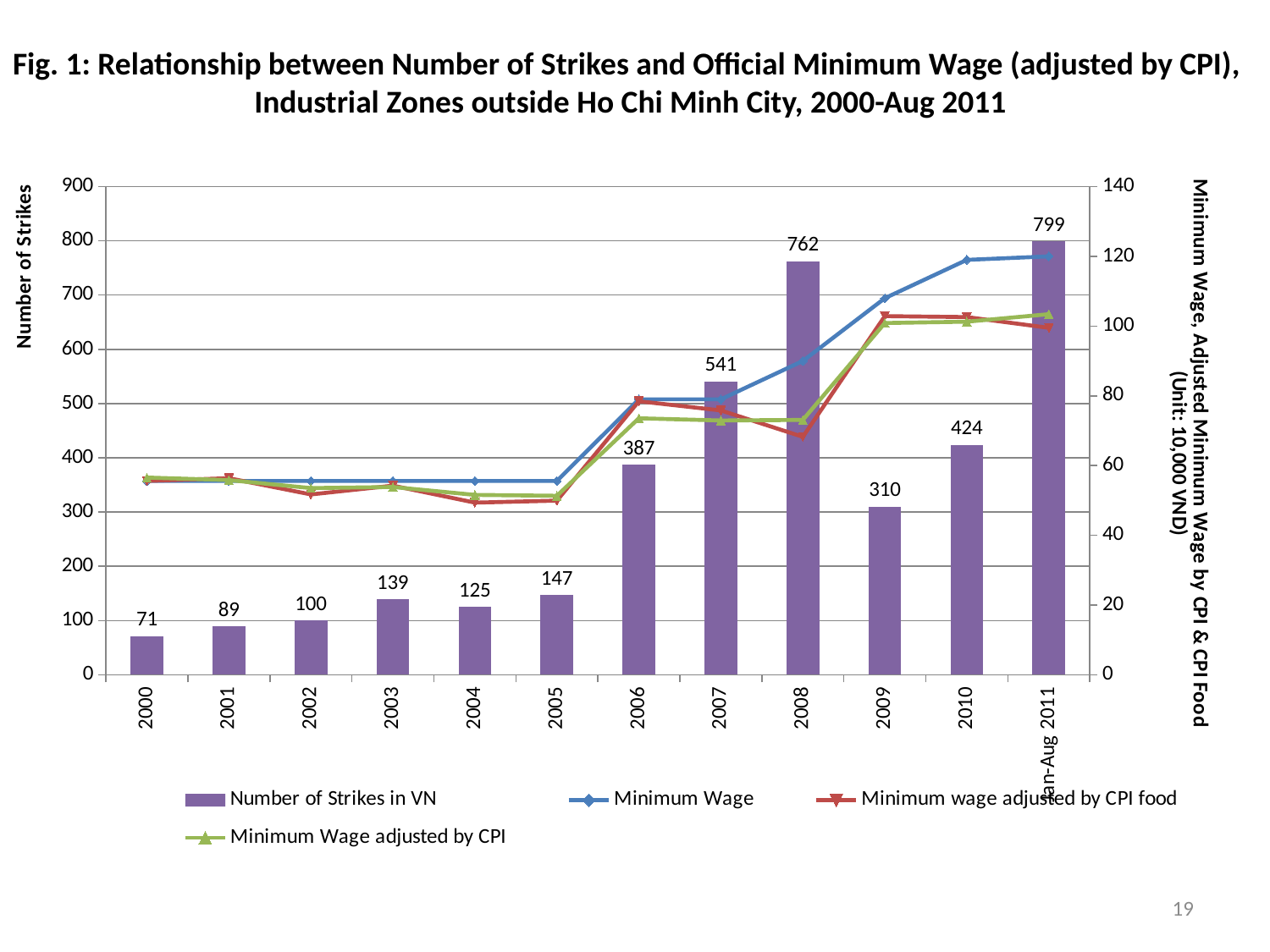
Which year has the lowest number of strikes? 2000 What is the unit given for the right-hand axis? 10,000 VND How many strikes were recorded in 2008? 762 Which period has the highest number of strikes? Jan-Aug 2011 How many time periods are shown on the x axis? 12 What is the number of strikes shown for 2004? 125 Is the Minimum Wage value for 2010 greater or less than 100? greater What is the number of strikes shown for Jan-Aug 2011? 799 Which year had more strikes, 2007 or 2010? 2007 How many series does the legend list? 4 Is the Minimum Wage value for 2005 greater or less than 60? less What is the difference in the number of strikes between 2008 and 2009? 452